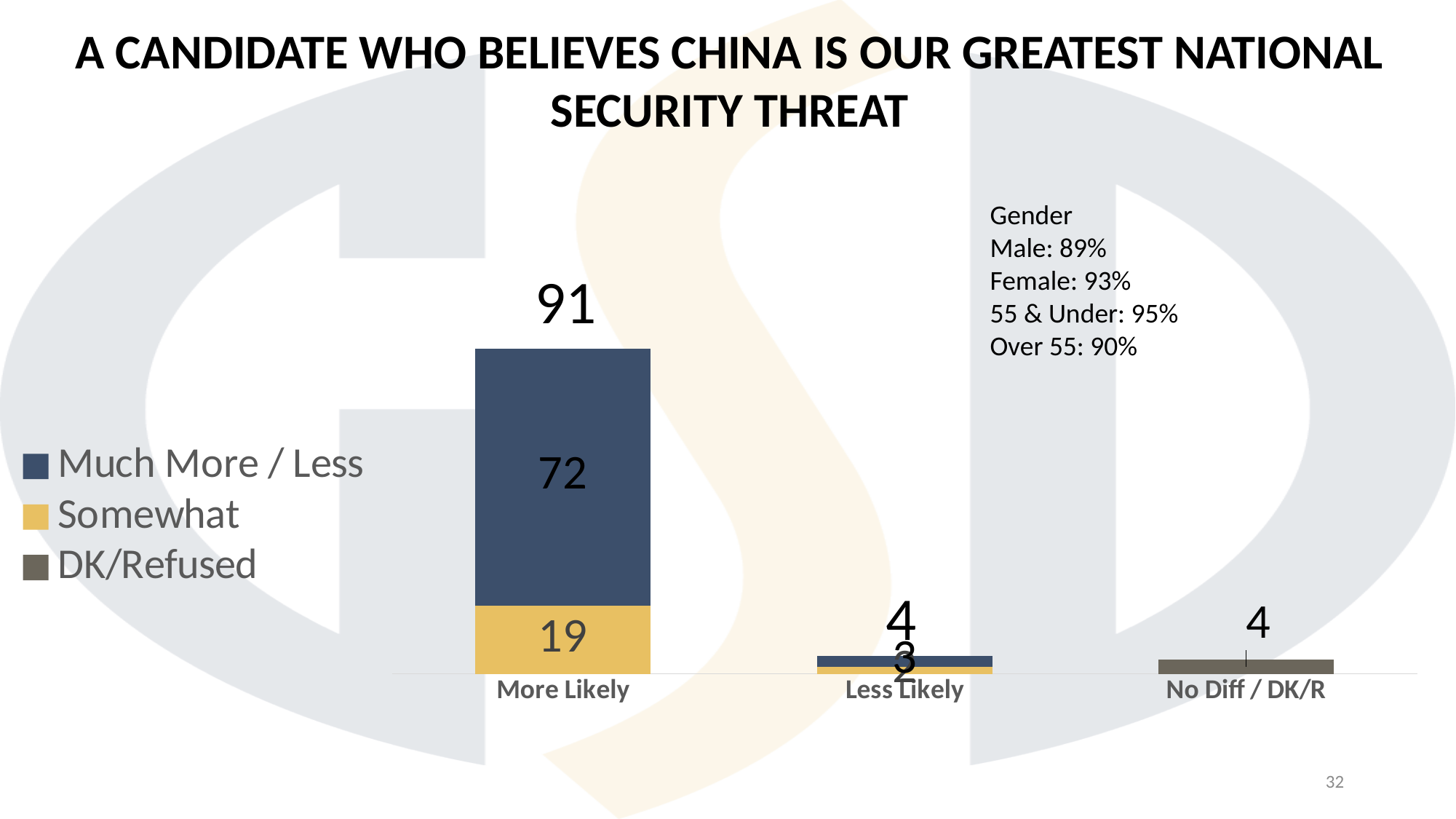
What is the value of the Much More / Less segment for More Likely? 72 What is the difference between the Much More / Less and Somewhat segments for More Likely? 53 How many series does the legend list? 3 What kind of chart is shown on the slide? Stacked bar chart How many categories are shown on the x axis? 3 What is the value shown for No Diff / DK/R? 4 What is the total shown above the Less Likely bar? 4 What is the value of the Somewhat segment for More Likely? 19 Which is larger for More Likely, the Much More / Less segment or the Somewhat segment? Much More / Less Which category has the highest total? More Likely Which legend entry is shown in gold/yellow? Somewhat What is the total shown above the More Likely bar? 91